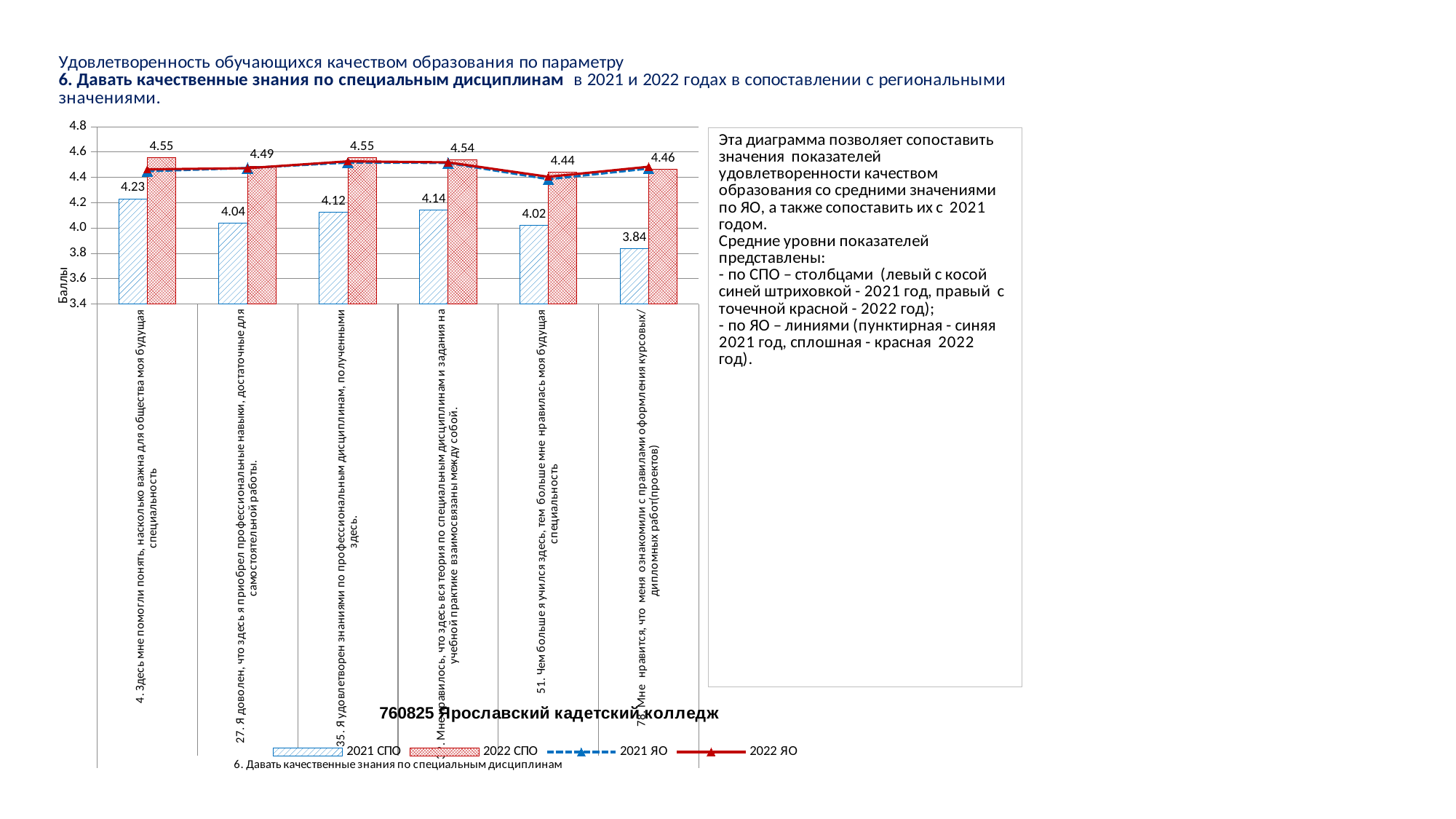
What is the difference between the 2022 СПО and 2021 СПО values for category 51? 0.42 What is the lowest 2022 СПО value shown on the chart? 4.44 How many series does the legend list? 4 What is the 2021 СПО value for category 51 (Чем больше я учился здесь, тем больше мне нравилась моя будущая специальность)? 4.02 Which category has the highest 2021 СПО value? 4. Здесь мне помогли понять, насколько важна для общества моя будущая специальность Is the 2021 ЯО value for category 4 greater or less than 4.2? greater What is the lowest 2021 СПО value shown on the chart? 3.84 What is the difference between the 2022 СПО and 2021 СПО values for category 4? 0.32 Which is larger: the 2022 СПО value for category 4 or for category 27? Category 4 What is the 2022 СПО value for category 27 (Я доволен, что здесь я приобрел профессиональные навыки)? 4.49 What is the 2021 СПО value for category 4 (Здесь мне помогли понять, насколько важна для общества моя будущая специальность)? 4.23 What is the 2022 СПО value for category 35 (Я удовлетворен знаниями по профессиональным дисциплинам)? 4.55